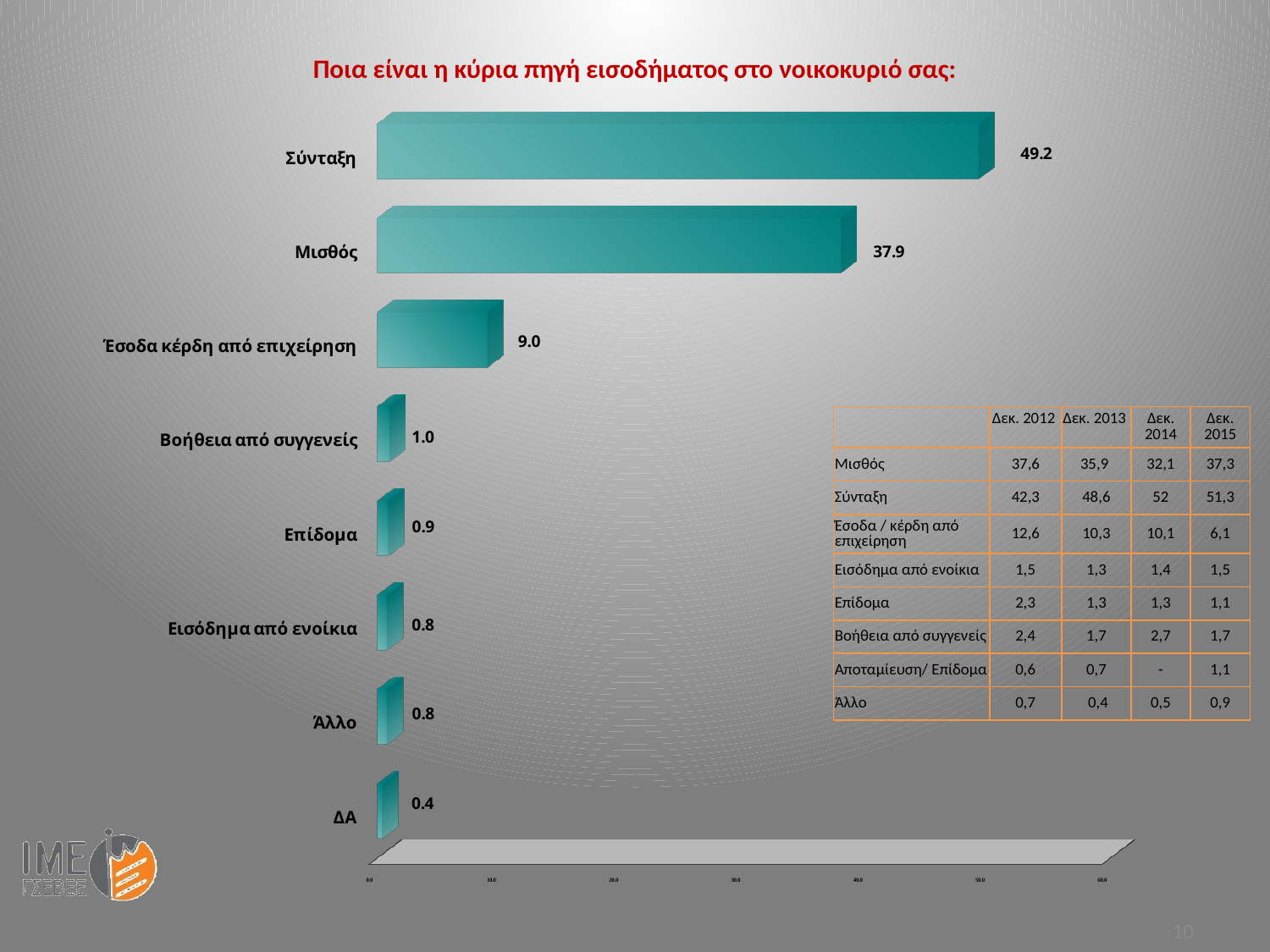
Which category has the lowest value in the bar chart? ΔΑ What is the title of the chart on the slide? Ποια είναι η κύρια πηγή εισοδήματος στο νοικοκυριό σας: What is the value for Μισθός in the bar chart? 37.9 What is the value for Έσοδα κέρδη από επιχείρηση in the bar chart? 9.0 What kind of chart is shown on the slide? Bar chart How many categories are shown in the bar chart? 8 What is the value for ΔΑ in the bar chart? 0.4 What is the difference between the values for Σύνταξη and Μισθός in the bar chart? 11.3 Which is larger in the bar chart: Βοήθεια από συγγενείς or Επίδομα? Βοήθεια από συγγενείς Which category has the highest value in the bar chart? Σύνταξη What is the difference between the values for Έσοδα κέρδη από επιχείρηση and Βοήθεια από συγγενείς in the bar chart? 8.0 What is the value for Σύνταξη in the bar chart? 49.2